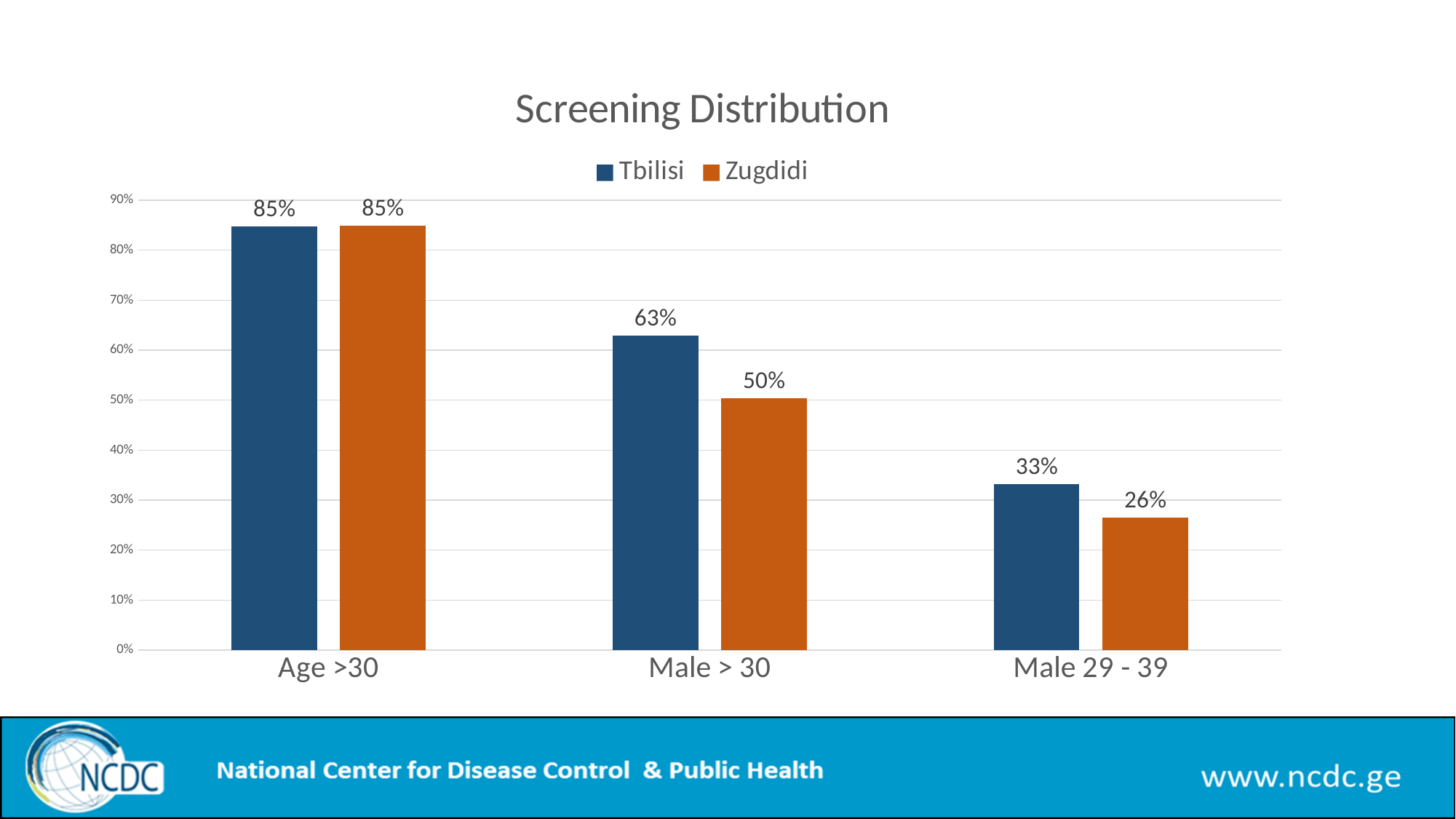
How many categories are shown on the x axis? 3 What kind of chart is shown on the slide? Bar chart How many series does the legend list? 2 What is the difference between the Tbilisi and Zugdidi values for Male > 30? 13% What is the Tbilisi value for Male 29 - 39? 33% What is the Zugdidi value for Age >30? 85% What is the Zugdidi value for Male 29 - 39? 26% Which category has the lowest Zugdidi value? Male 29 - 39 What is the Tbilisi value for Male > 30? 63% What is the difference between the Tbilisi and Zugdidi values for Male 29 - 39? 7% Which category has the highest Tbilisi value? Age >30 Which is larger for Male > 30, the Tbilisi value or the Zugdidi value? Tbilisi